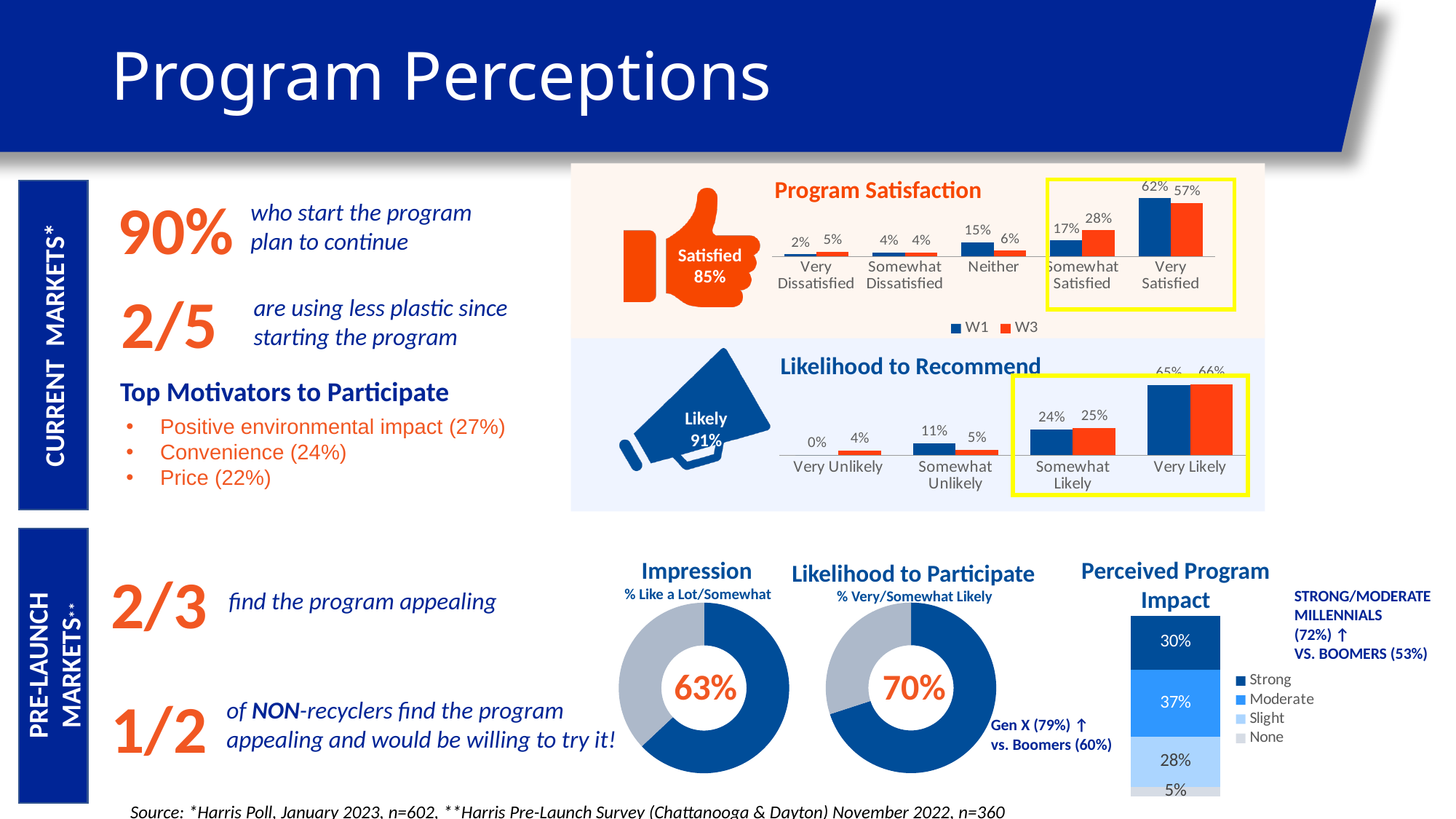
In the Likelihood to Recommend chart, what is the W1 value for Somewhat Unlikely? 11% In the Program Satisfaction chart, which category has the highest W1 value? Very Satisfied In the Perceived Program Impact chart, which segment is the smallest? None In the Program Satisfaction chart, what is the W3 value for Somewhat Satisfied? 28% In the Program Satisfaction chart, what is the W1 value for Very Satisfied? 62% In the Program Satisfaction chart, what is the difference between the W1 and W3 values for Neither? 9% What percentage is shown in the centre of the Impression donut chart? 63% How many series does the legend of the Program Satisfaction chart list? 2 In the Likelihood to Recommend chart, which is larger for Somewhat Unlikely, W1 or W3? W1 How many categories are shown on the x axis of the Likelihood to Recommend chart? 4 In the Likelihood to Recommend chart, what is the W3 value for Very Unlikely? 4% In the Perceived Program Impact chart, what is the value for Moderate? 37%